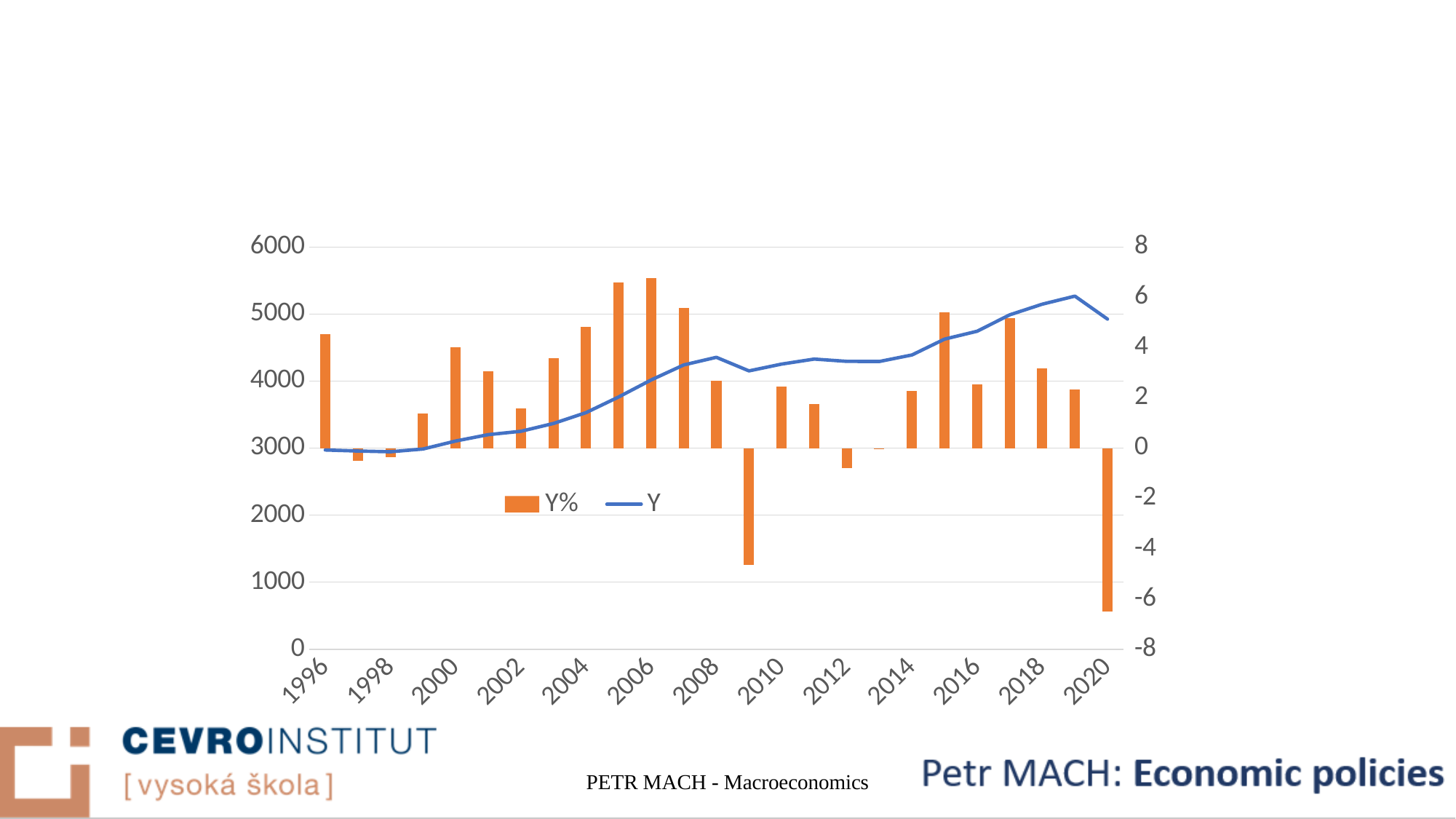
What are the two series named in the legend? Y% and Y In which year is the Y% bar the highest? 2006 Does the Y line generally rise or fall from 1996 to 2019? rise Is the Y line value for 2002 greater or less than 4000? less Is the Y line value for 2019 greater or less than 5000? greater How many series does the legend list? 2 What kind of chart is shown on the slide? A combination bar and line chart In which year is the Y% bar the lowest? 2020 Which year has the larger Y% bar, 2015 or 2016? 2015 Is the Y% value for 2006 greater or less than 6? greater Which series is drawn as a blue line? Y